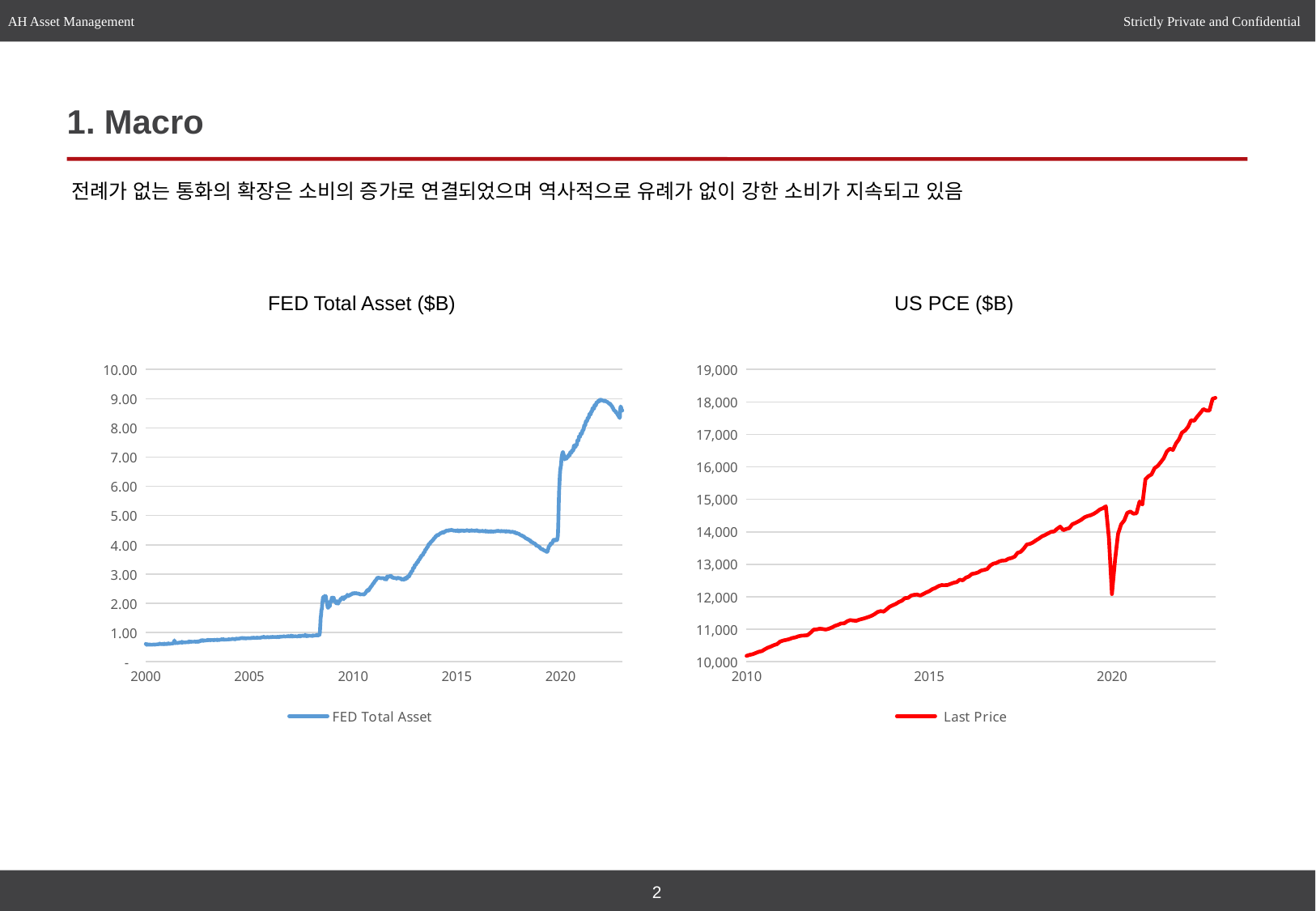
In the US PCE ($B) chart, is the value in 2010 greater or less than 11,000? less How many series does the legend of the US PCE ($B) chart list? 1 In the US PCE ($B) chart, is the value in 2012 greater or less than 12,000? less What kind of chart is the US PCE ($B) chart? line chart What colour is the line in the FED Total Asset ($B) chart? blue What is the legend entry of the US PCE ($B) chart? Last Price How many series does the legend of the FED Total Asset ($B) chart list? 1 In the US PCE ($B) chart, do the values generally rise or fall from 2010 to the end of the series? rise In the FED Total Asset ($B) chart, do the values generally rise or fall from 2000 to 2020? rise In the FED Total Asset ($B) chart, is the value in 2000 greater or less than 1.00? less What kind of chart is the FED Total Asset ($B) chart? line chart